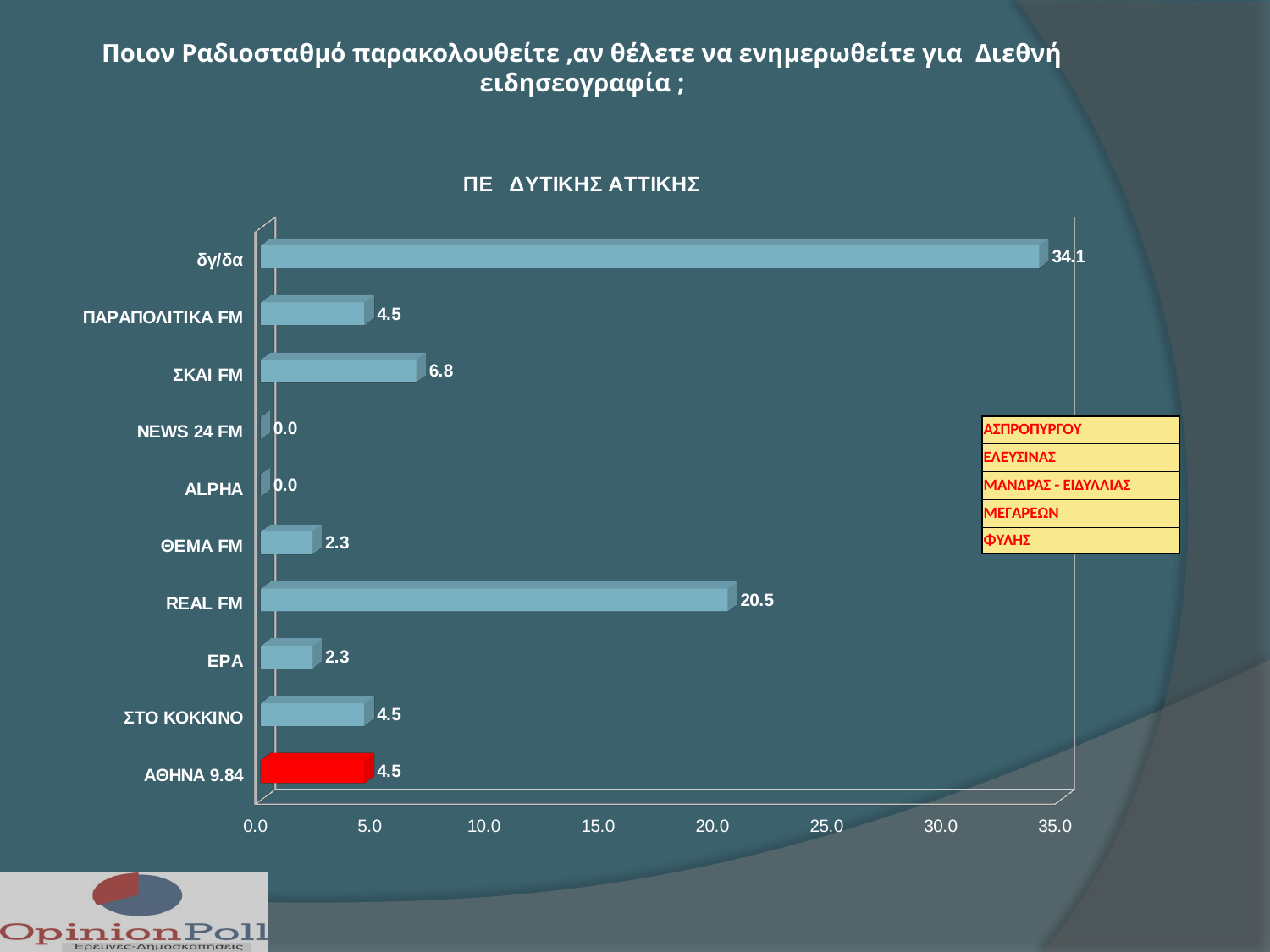
What is the value for ΣΚΑΙ FM? 6.8 What is the difference between the values for δγ/δα and REAL FM? 13.6 Which is larger, the value for ΣΚΑΙ FM or the value for ΠΑΡΑΠΟΛΙΤΙΚΑ FM? ΣΚΑΙ FM What is the value for ΑΘΗΝΑ 9.84? 4.5 Is the value for REAL FM greater or less than 15.0? greater What is the title of the chart? ΠΕ ΔΥΤΙΚΗΣ ΑΤΤΙΚΗΣ Which category has the highest value? δγ/δα What kind of chart is shown on the slide? bar chart Which category's bar is coloured red? ΑΘΗΝΑ 9.84 What is the value for ΘΕΜΑ FM? 2.3 What is the value for REAL FM? 20.5 How many categories are shown on the chart? 10